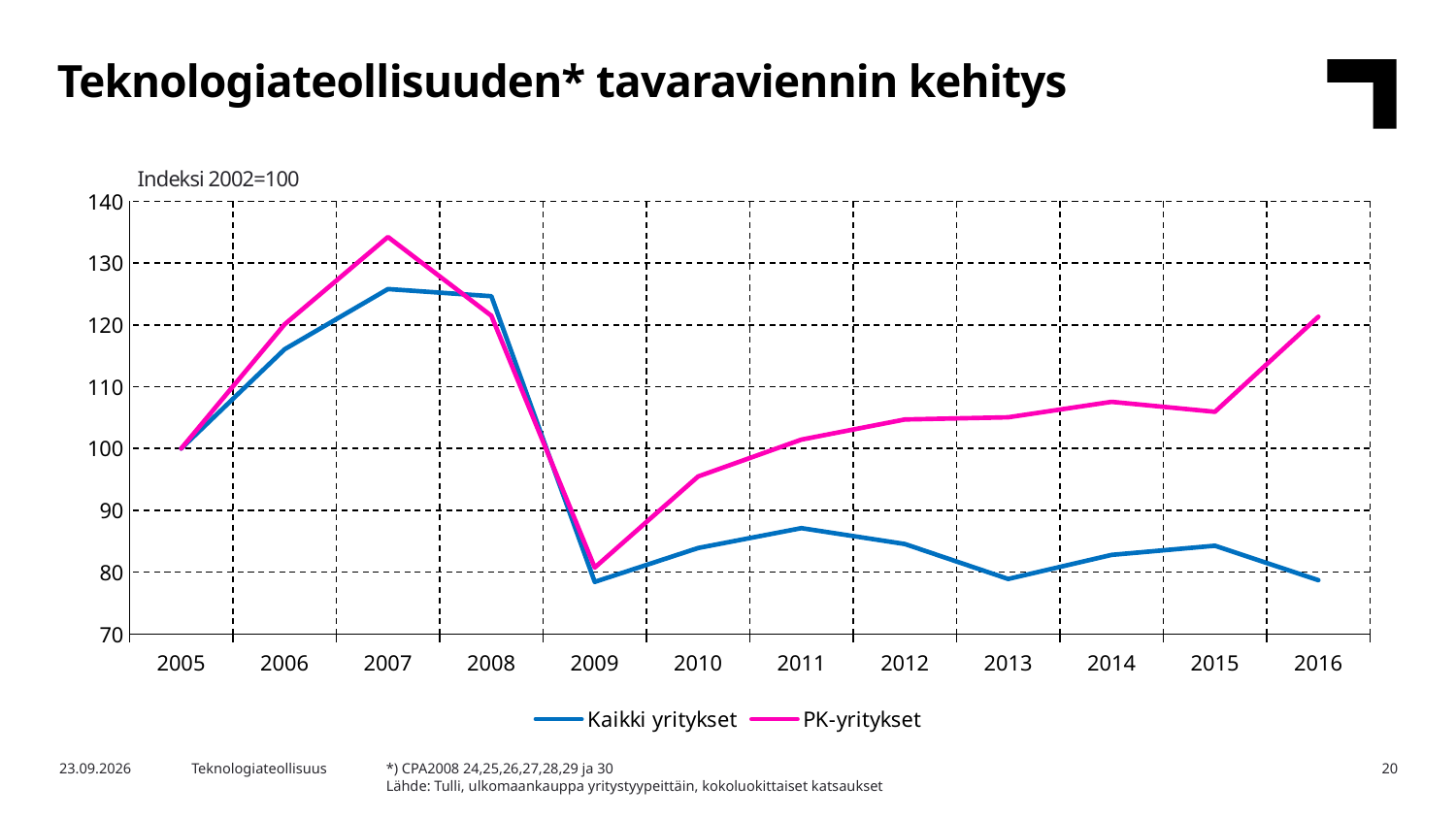
How many series does the legend list? 2 Is the value for PK-yritykset in 2016 greater or less than 110? greater How many years are shown on the x axis? 12 What is the index value for Kaikki yritykset in 2005? 100 Is the value for Kaikki yritykset in 2013 greater or less than 90? less Which series has the higher value in 2016, Kaikki yritykset or PK-yritykset? PK-yritykset In which year does PK-yritykset reach its highest value? 2007 What kind of chart is shown on the slide? line chart What is the title of the slide? Teknologiateollisuuden* tavaraviennin kehitys In which year does PK-yritykset reach its lowest value? 2009 Does the Kaikki yritykset line rise or fall from 2005 to 2007? rise Is the value for Kaikki yritykset in 2007 greater or less than 120? greater